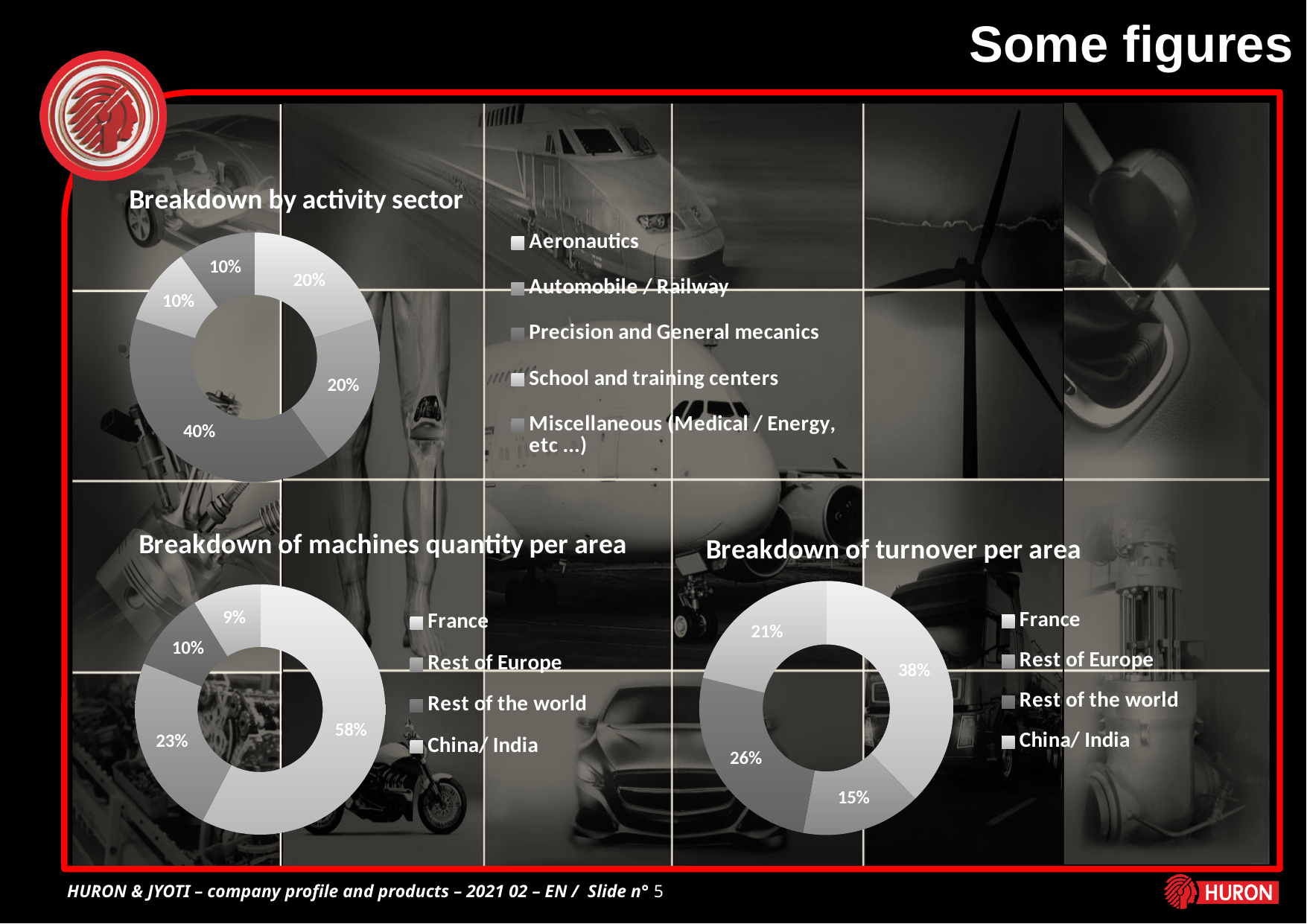
In the 'Breakdown by activity sector' chart, how many activity sectors does the legend list? 5 What kind of chart is used for 'Breakdown by activity sector'? Doughnut chart In the 'Breakdown of turnover per area' chart, what is the share for France? 38% In the 'Breakdown of turnover per area' chart, how many areas does the legend list? 4 In the 'Breakdown of machines quantity per area' chart, which area has the smallest share? China/ India In the 'Breakdown of turnover per area' chart, what is the share for Rest of Europe? 15% In the 'Breakdown by activity sector' chart, what is the smallest share shown? 10% In the 'Breakdown of turnover per area' chart, which is larger: Rest of the world or China/ India? Rest of the world In the 'Breakdown by activity sector' chart, what is the largest share shown? 40% How many charts are shown on the slide? 3 In the 'Breakdown of machines quantity per area' chart, what is the share for France? 58% In the 'Breakdown of machines quantity per area' chart, what is the difference between the France share and the Rest of Europe share? 35%